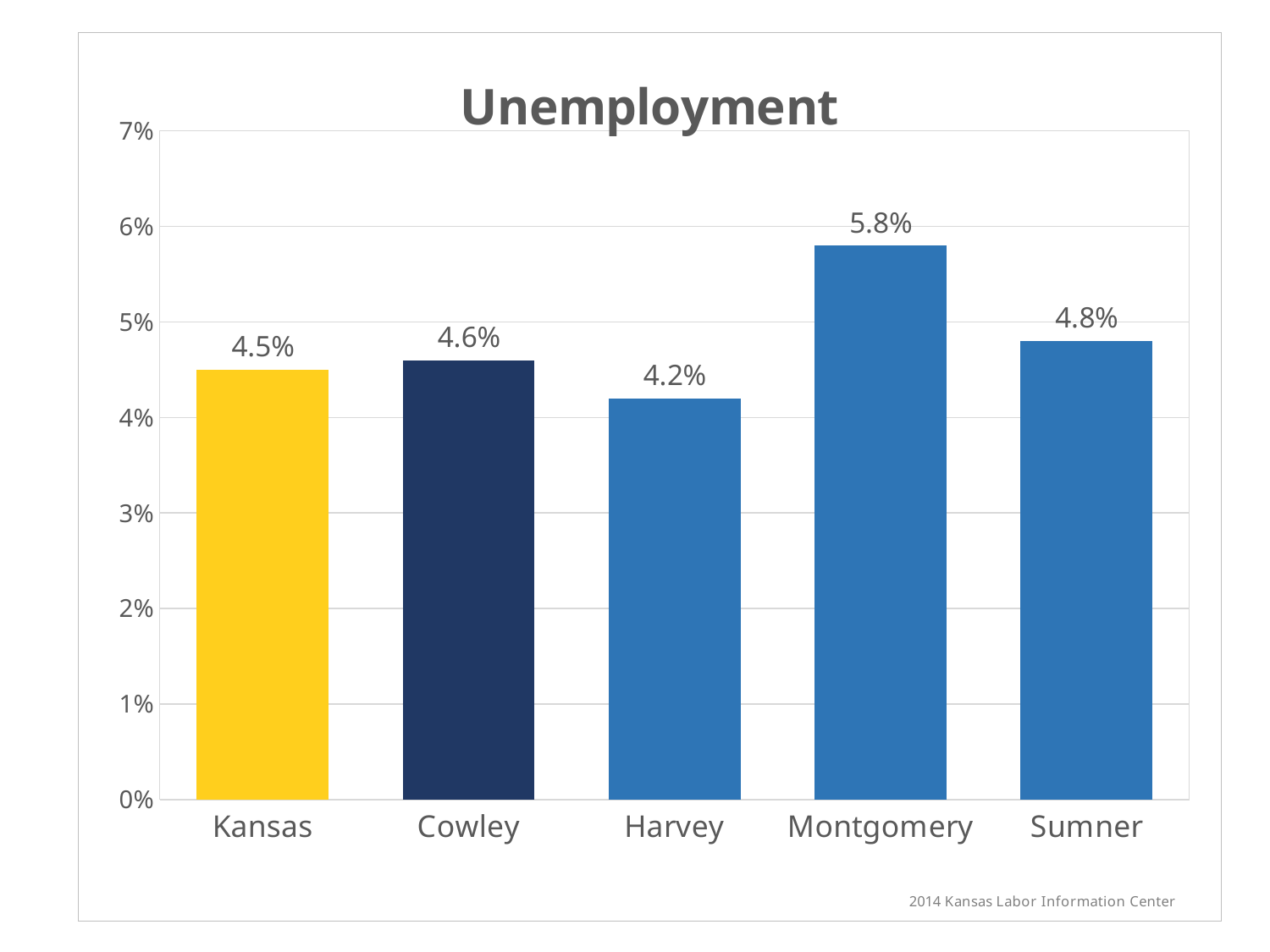
Which has a higher unemployment rate, Sumner or Cowley? Sumner What is the unemployment rate for Montgomery? 5.8% What is the difference between the unemployment rates of Sumner and Kansas? 0.3% What is the difference between the unemployment rates of Montgomery and Harvey? 1.6% What kind of chart is shown on the slide? Bar chart Which category has the highest unemployment rate? Montgomery Is the value for Montgomery greater or less than 5%? greater Which category has the lowest unemployment rate? Harvey How many categories are shown on the x axis? 5 What is the title of the chart? Unemployment What is the unemployment rate for Harvey? 4.2% What is the unemployment rate for Kansas? 4.5%